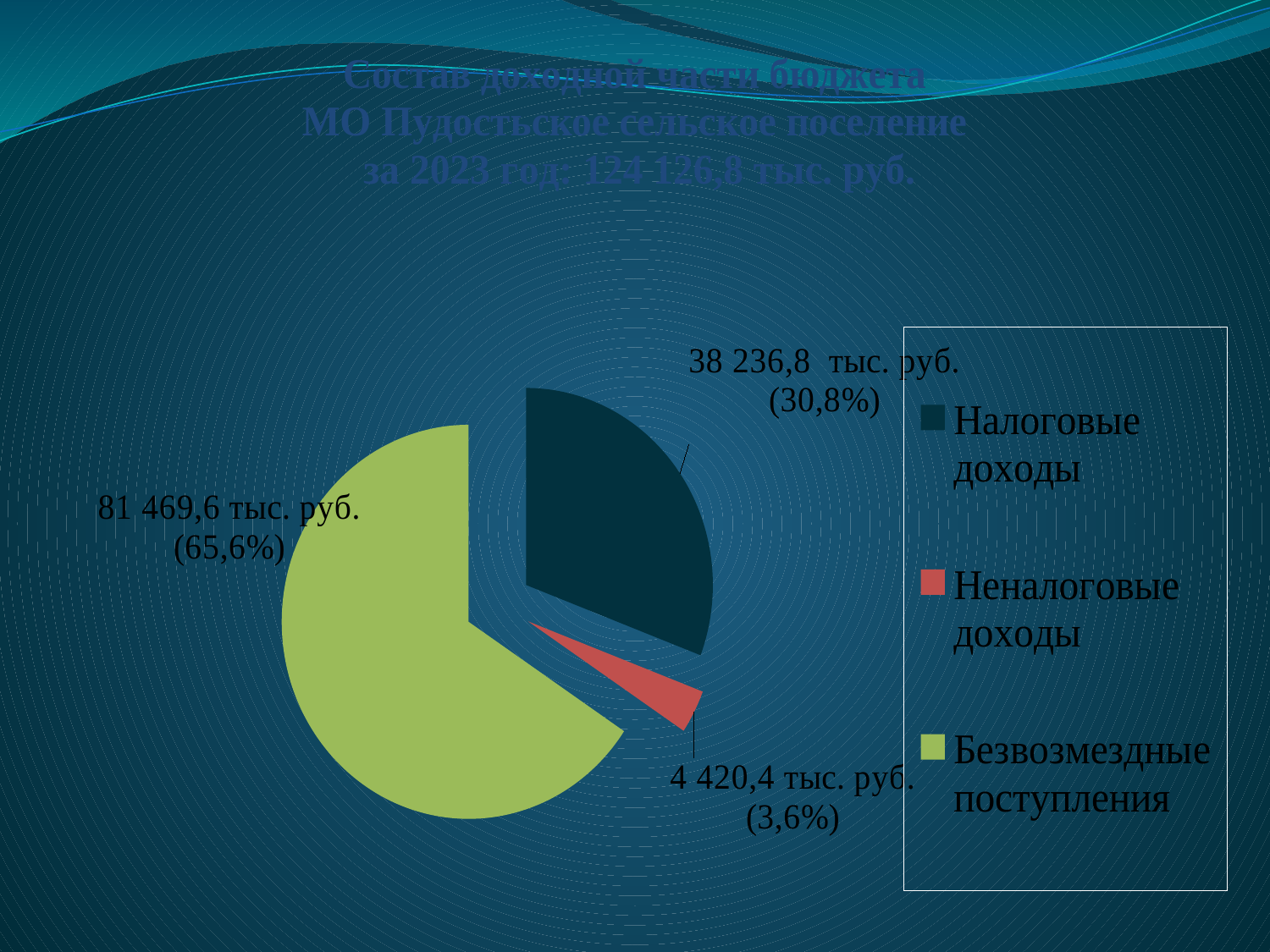
Which category has the largest slice of the pie? Безвозмездные поступления What is the value shown for Налоговые доходы? 38 236,8 тыс. руб. How many slices does the pie chart have? 3 What colour is the slice for Неналоговые доходы? Red What is the value shown for Неналоговые доходы? 4 420,4 тыс. руб. What share of the pie does Налоговые доходы represent? 30,8% What share of the pie does Безвозмездные поступления represent? 65,6% What is the value shown for Безвозмездные поступления? 81 469,6 тыс. руб. Which category has the smallest slice of the pie? Неналоговые доходы What kind of chart is shown on the slide? Pie chart How many entries does the legend list? 3 Which is larger, Налоговые доходы or Неналоговые доходы? Налоговые доходы